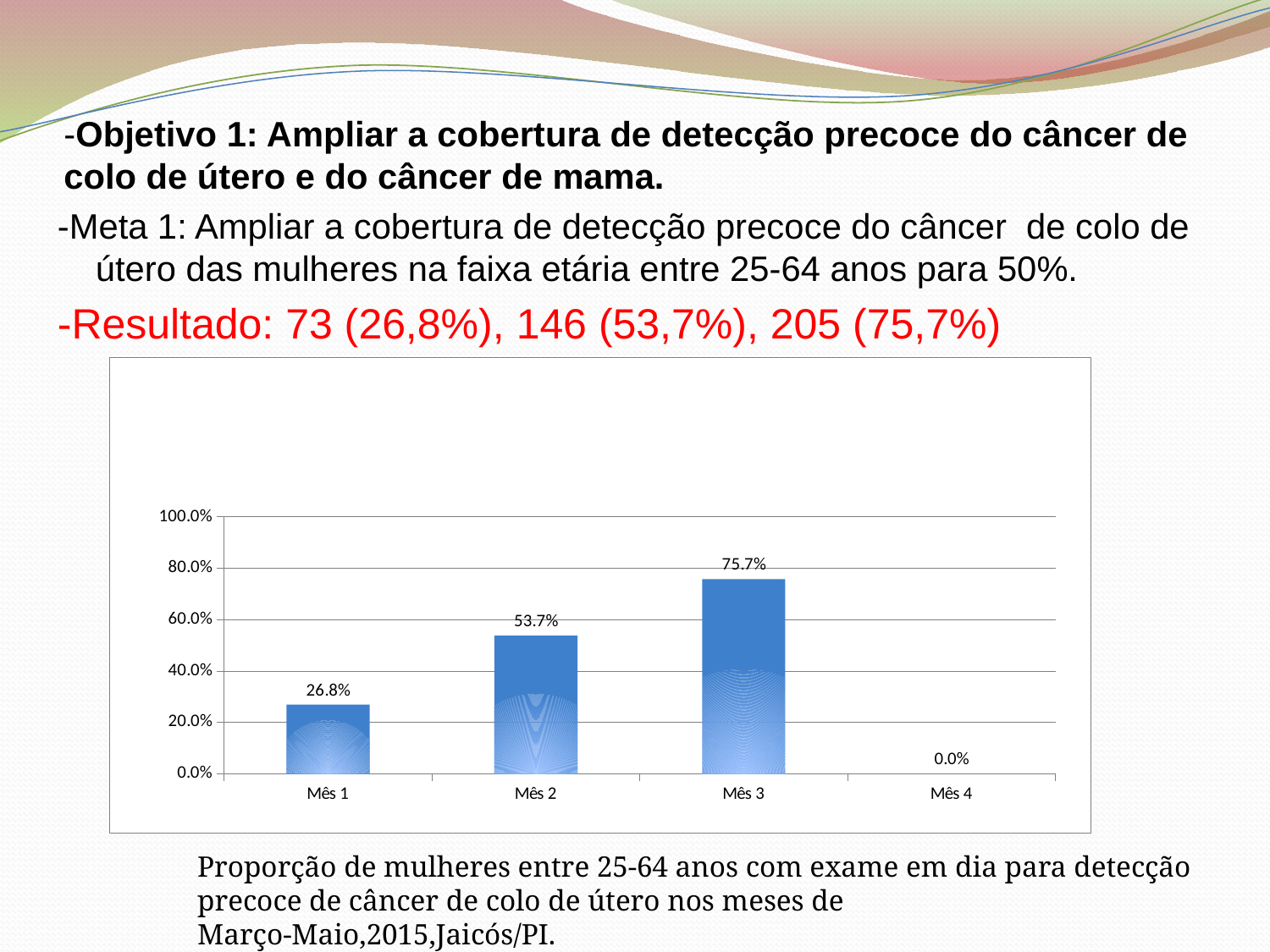
What is the value for Mês 3? 75.7% What is the value for Mês 2? 53.7% Do the values rise or fall from Mês 1 to Mês 3? Rise What is the difference between the values for Mês 3 and Mês 1? 48.9% Which is larger, the value for Mês 2 or the value for Mês 3? Mês 3 Which month has the lowest value? Mês 4 What is the value for Mês 1? 26.8% What is the value for Mês 4? 0.0% What is the difference between the values for Mês 2 and Mês 1? 26.9% How many categories are shown on the x axis? 4 What kind of chart is shown on the slide? Bar chart Which month has the highest value? Mês 3